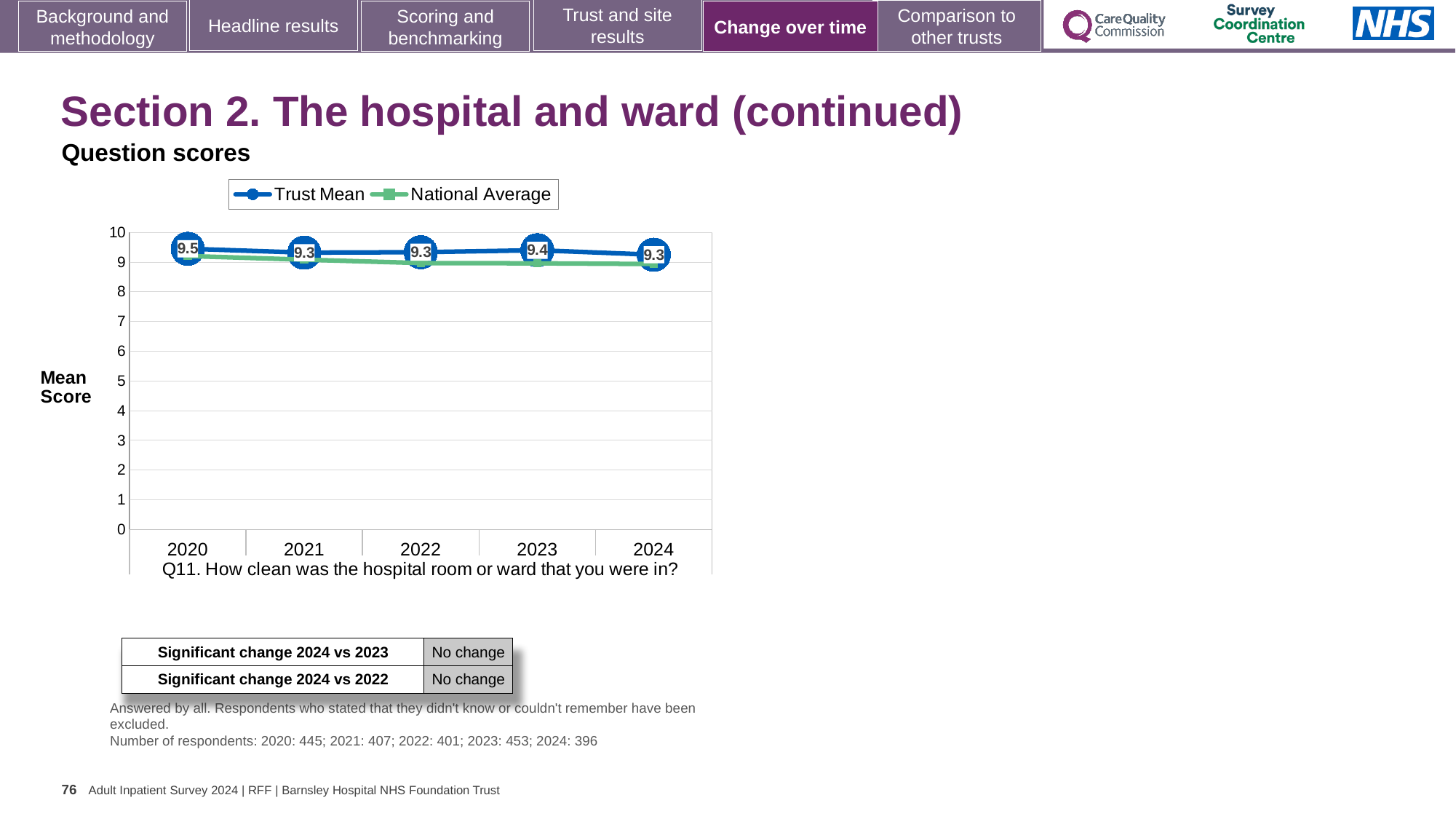
In which year is the Trust Mean score highest? 2020 What kind of chart is shown on the slide? line chart What is the Trust Mean score for 2023? 9.4 What is the Trust Mean score for 2020? 9.5 Which year has the larger Trust Mean score, 2020 or 2024? 2020 How many series does the chart legend list? 2 Which survey question does the chart show scores for? Q11. How clean was the hospital room or ward that you were in? How many years are shown on the x axis of the chart? 5 What is the Trust Mean score for 2024? 9.3 What is the difference between the Trust Mean scores for 2020 and 2021? 0.2 Is the National Average value for 2024 greater or less than 8? greater Does the Trust Mean score rise or fall from 2020 to 2024? fall